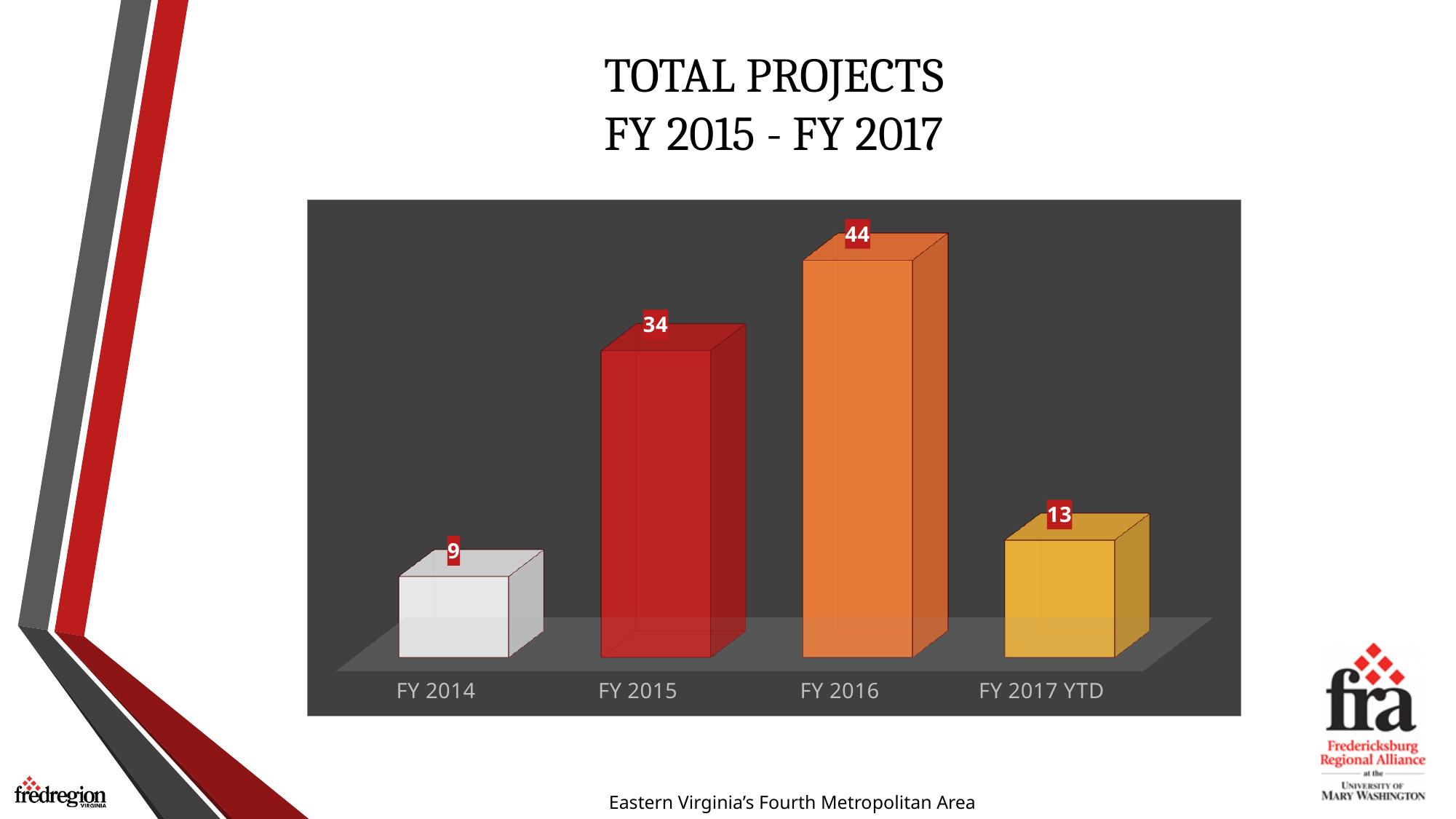
What is the value for FY 2017 YTD? 13 What is the difference between the values for FY 2017 YTD and FY 2014? 4 What is the title of the chart? TOTAL PROJECTS FY 2015 - FY 2017 What is the value for FY 2015? 34 What is the value for FY 2016? 44 What kind of chart is shown on the slide? Bar chart Which category has the highest value? FY 2016 How many categories are shown on the x axis? 4 What is the difference between the values for FY 2016 and FY 2015? 10 Which category has the lowest value? FY 2014 What is the value for FY 2014? 9 Which is larger, the value for FY 2015 or the value for FY 2017 YTD? FY 2015